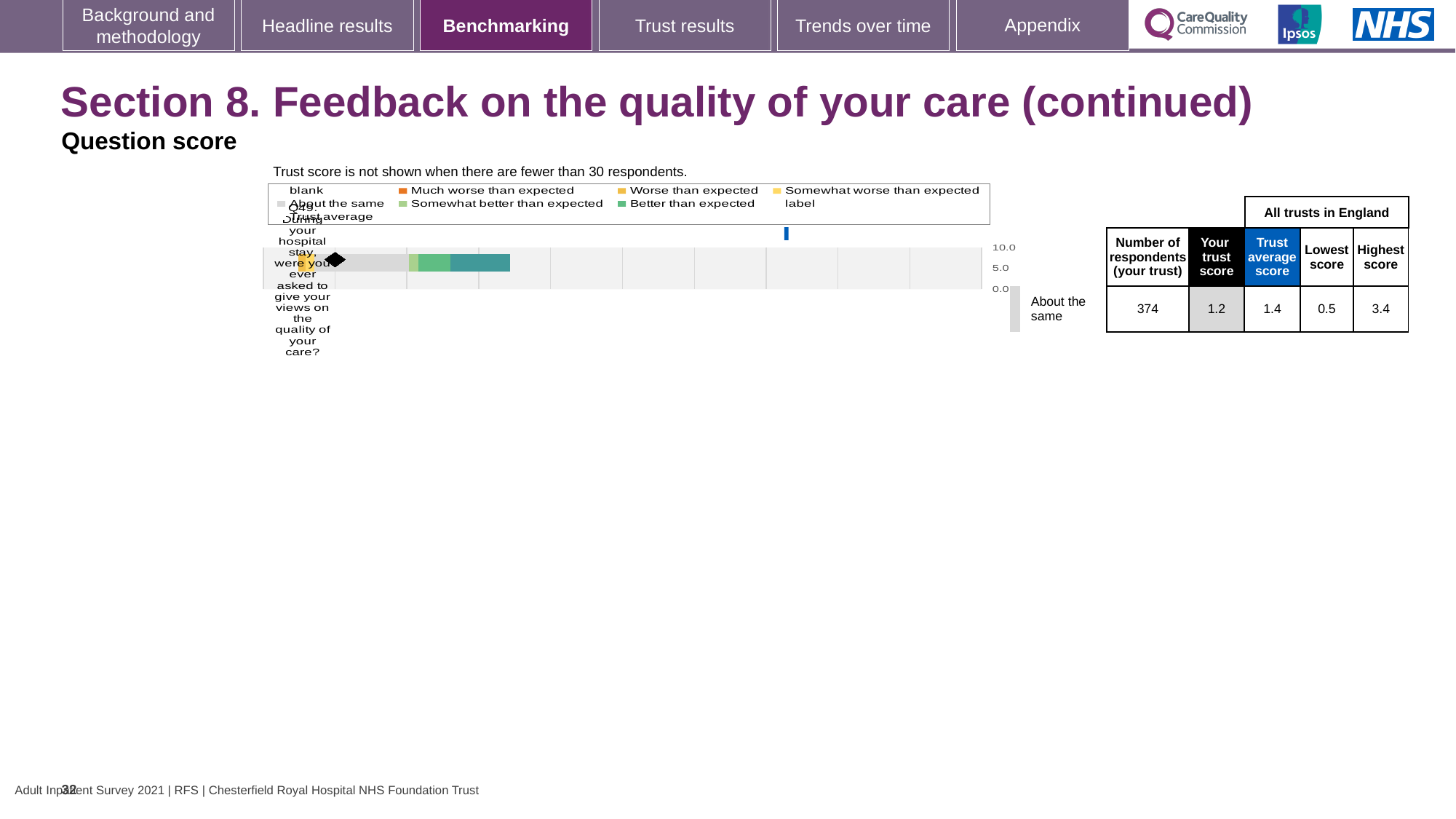
What is the trust score for Q49 shown in the table next to the chart? 1.2 What is the lowest score across all trusts in England for Q49? 0.5 What is the highest score across all trusts in England for Q49? 3.4 What is the difference between the highest and lowest scores across all trusts in England for Q49? 2.9 How many respondents from the trust answered Q49? 374 How many questions (categories) are plotted in the chart? 1 Which is larger for Q49, the trust score or the trust average score? trust average score Is the trust score marker for Q49 greater or less than 5.0? less What is the highest value shown on the chart's axis? 10.0 What kind of chart is shown on the slide? bar chart Which question is plotted in the chart? Q49. During your hospital stay, were you ever asked to give your views on the quality of your care? What is the trust average score for Q49 shown in the table next to the chart? 1.4